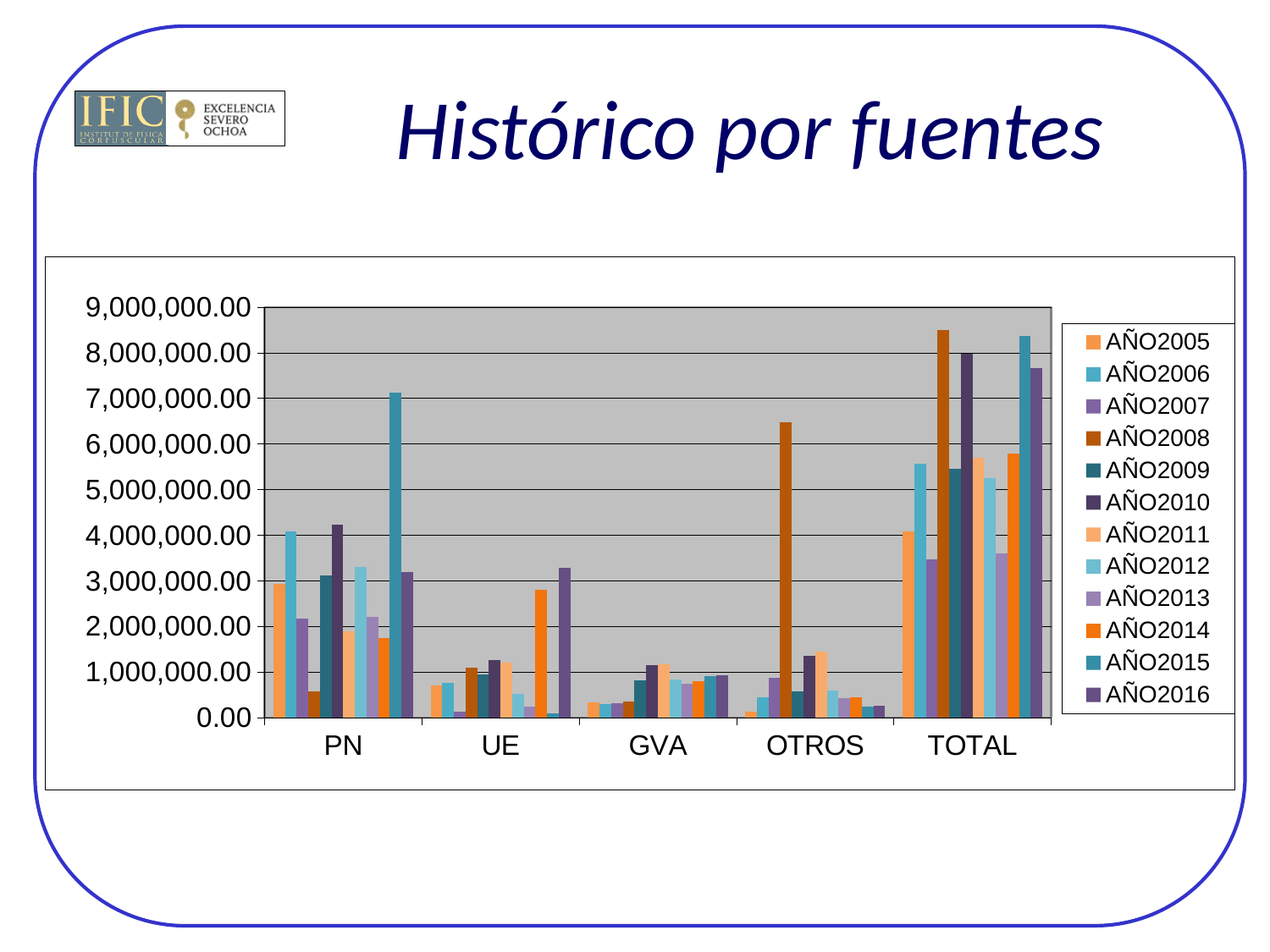
What kind of chart is shown on the slide? bar chart How many series does the legend list? 12 Is the value for AÑO2008 in the OTROS category greater or less than 6,000,000.00? greater In the UE category, which year has the highest bar? AÑO2016 Is the value for AÑO2015 in the PN category greater or less than 6,000,000.00? greater How many categories are shown on the x axis? 5 In the PN category, which is larger: AÑO2006 or AÑO2008? AÑO2006 Is the value for AÑO2007 in the TOTAL category greater or less than 4,000,000.00? less In the TOTAL category, which is larger: AÑO2008 or AÑO2007? AÑO2008 What is the title of the slide containing the chart? Histórico por fuentes In the OTROS category, which year has the highest bar? AÑO2008 In the PN category, which year has the highest bar? AÑO2015